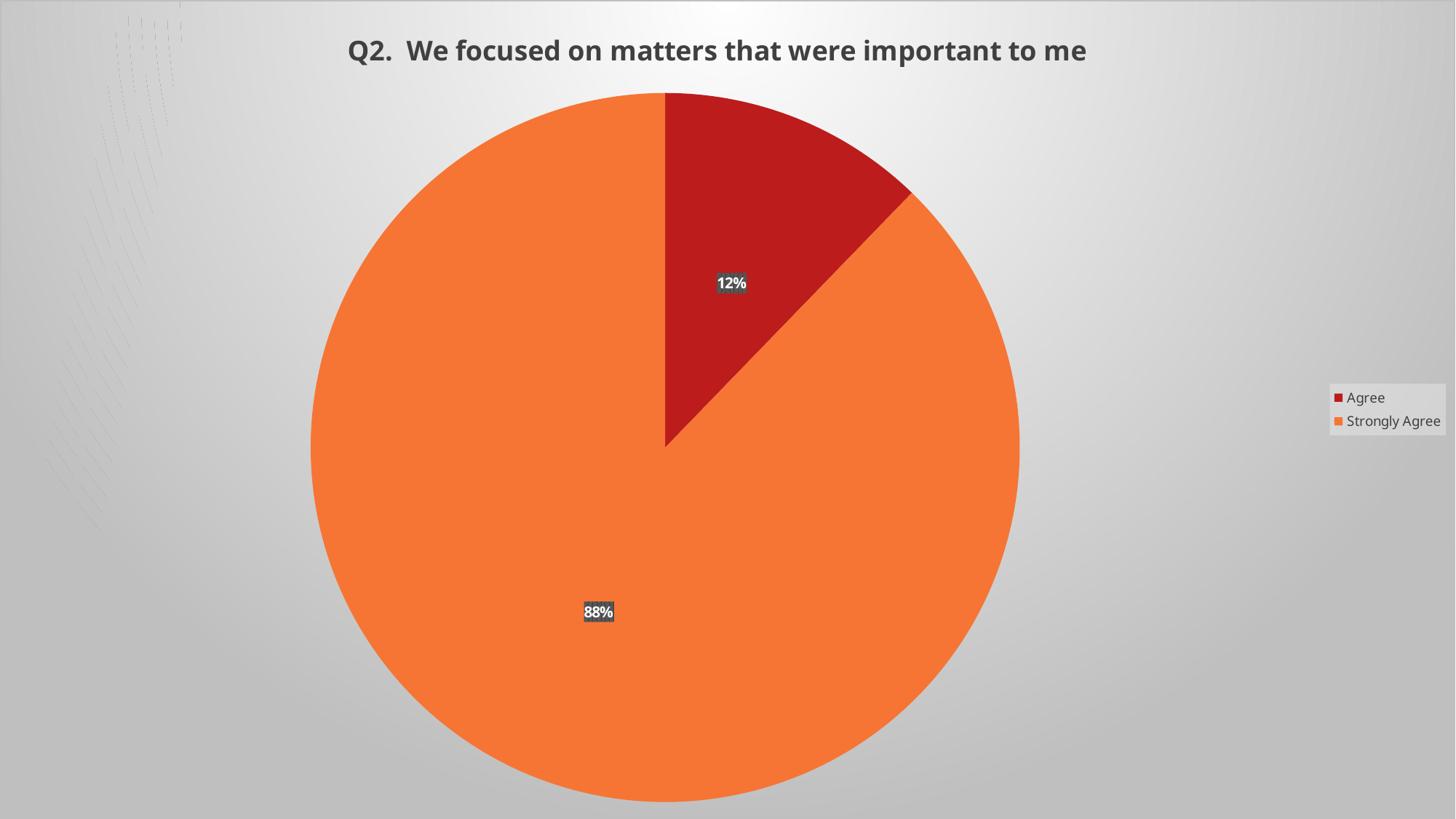
What is the title of the chart? Q2. We focused on matters that were important to me Which category has the smallest slice of the pie? Agree How many entries does the legend list? 2 How many slices does the pie chart have? 2 What is the difference in percentage points between the "Strongly Agree" and "Agree" slices? 76 Which category has the largest slice of the pie? Strongly Agree What kind of chart is shown on the slide? Pie chart What percentage of the pie is labelled "Strongly Agree"? 88% Which is larger, the "Agree" slice or the "Strongly Agree" slice? Strongly Agree What colour is the "Strongly Agree" slice? Orange What percentage of the pie is labelled "Agree"? 12% What share of the pie does the "Agree" slice represent? 12%